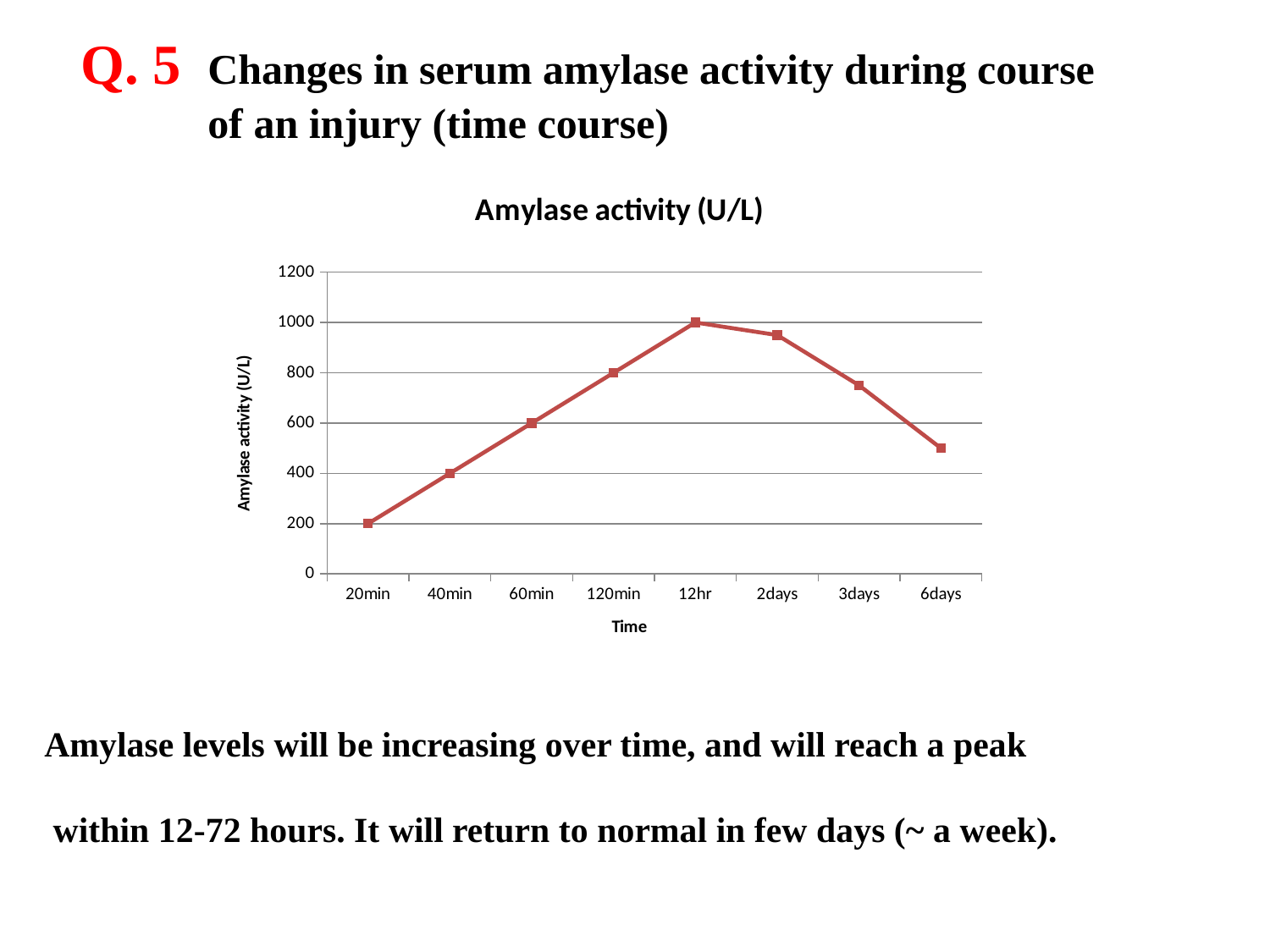
What is the amylase activity at 20min? 200 What is the amylase activity at 12hr? 1000 At which time point is amylase activity highest? 12hr What is the label of the x axis? Time What is the difference in amylase activity between 12hr and 20min? 800 How many time points are plotted on the x axis? 8 What type of chart is shown on the slide? line chart At which time point is amylase activity lowest? 20min Is the value for 2days greater or less than 800? greater Which has higher amylase activity, 40min or 60min? 60min Is the value for 6days greater or less than 600? less What is the amylase activity at 120min? 800